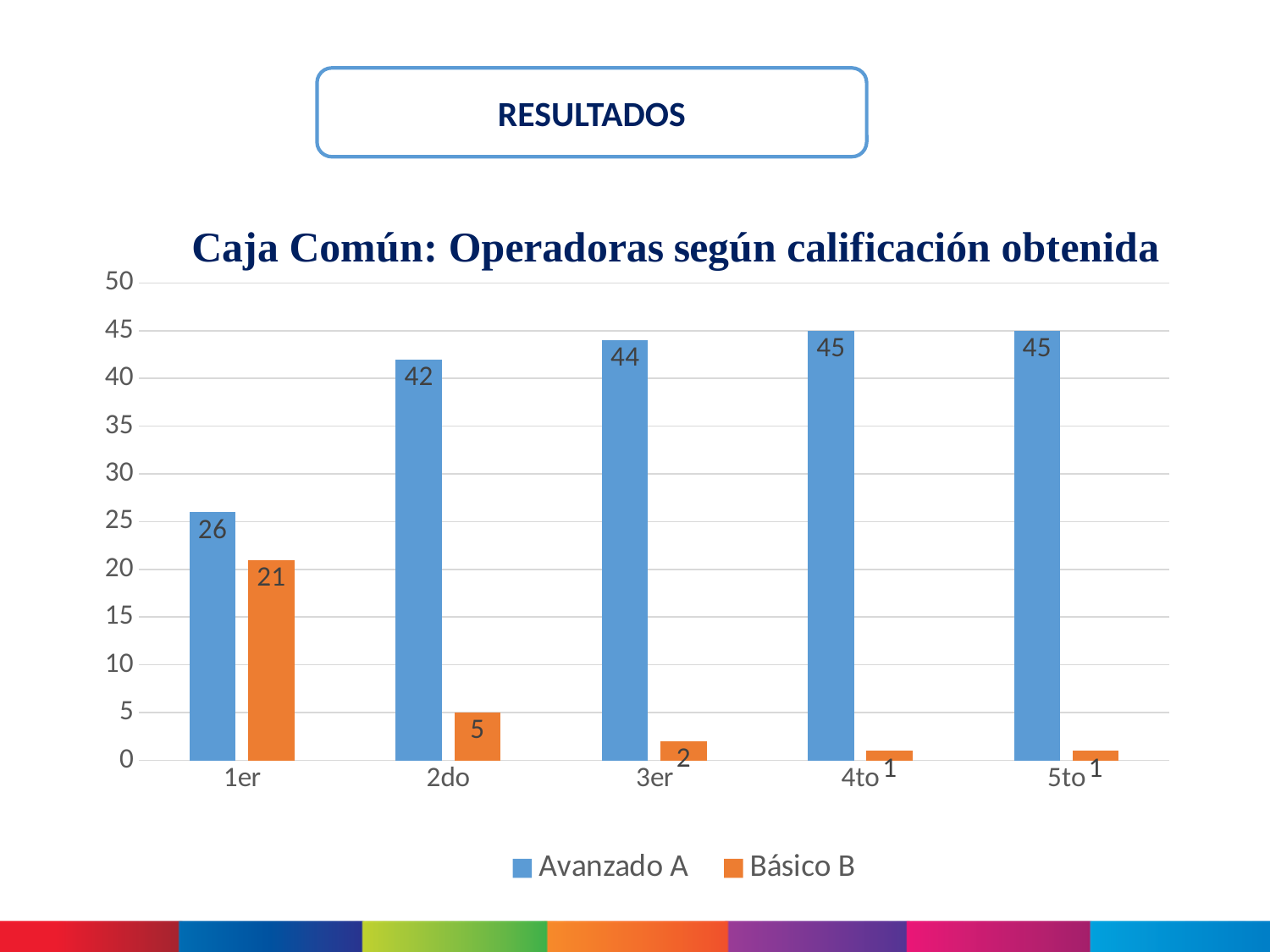
Which category has the lowest value for Avanzado A? 1er What is the difference between the Avanzado A values for 3er and 2do? 2 How many categories are shown on the x axis? 5 What is the value for Avanzado A in the 2do category? 42 Which category has the highest value for Básico B? 1er Which is larger in the 2do category, Avanzado A or Básico B? Avanzado A What is the value for Básico B in the 3er category? 2 What is the title of the chart? Caja Común: Operadoras según calificación obtenida How many series does the legend list? 2 What kind of chart is shown on the slide? Bar chart What is the difference between Avanzado A and Básico B in the 1er category? 5 What is the value for Básico B in the 1er category? 21